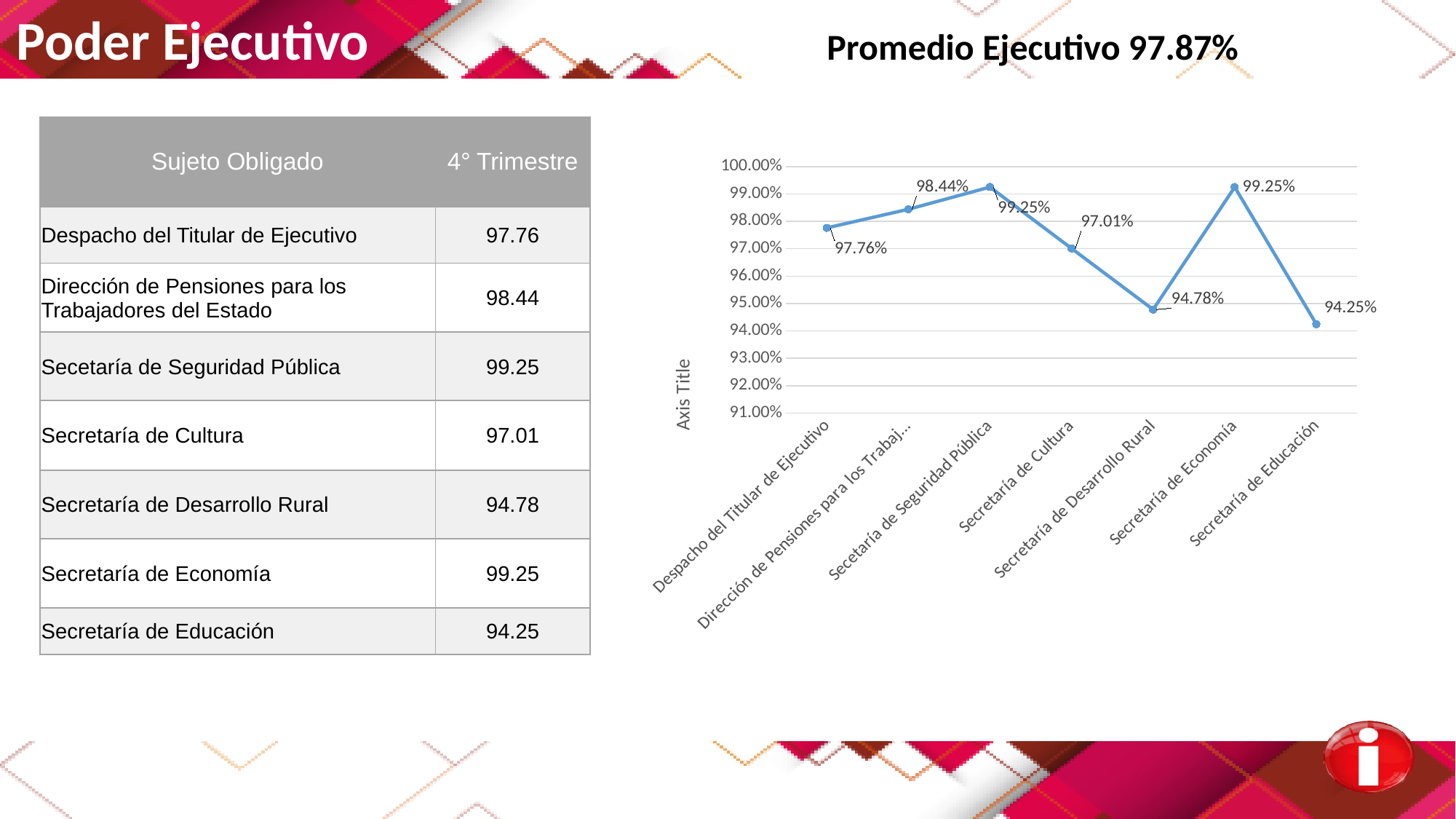
Which is larger, the value for Despacho del Titular de Ejecutivo or the value for Secretaría de Desarrollo Rural? Despacho del Titular de Ejecutivo What kind of chart is shown on the slide? line chart Is the value for Secretaría de Educación greater or less than 95.00%? less What is the value plotted for Despacho del Titular de Ejecutivo? 97.76% What is the difference between the values for Secretaría de Cultura and Secretaría de Desarrollo Rural? 2.23% Which category has the lowest value on the chart? Secretaría de Educación What is the difference between the values for Secretaría de Seguridad Pública and Secretaría de Educación? 5.00% How many categories are plotted on the chart? 7 What is the label shown on the vertical axis of the chart? Axis Title What is the value plotted for Secretaría de Economía? 99.25% What is the value plotted for Secretaría de Desarrollo Rural? 94.78% What is the value plotted for Secretaría de Cultura? 97.01%